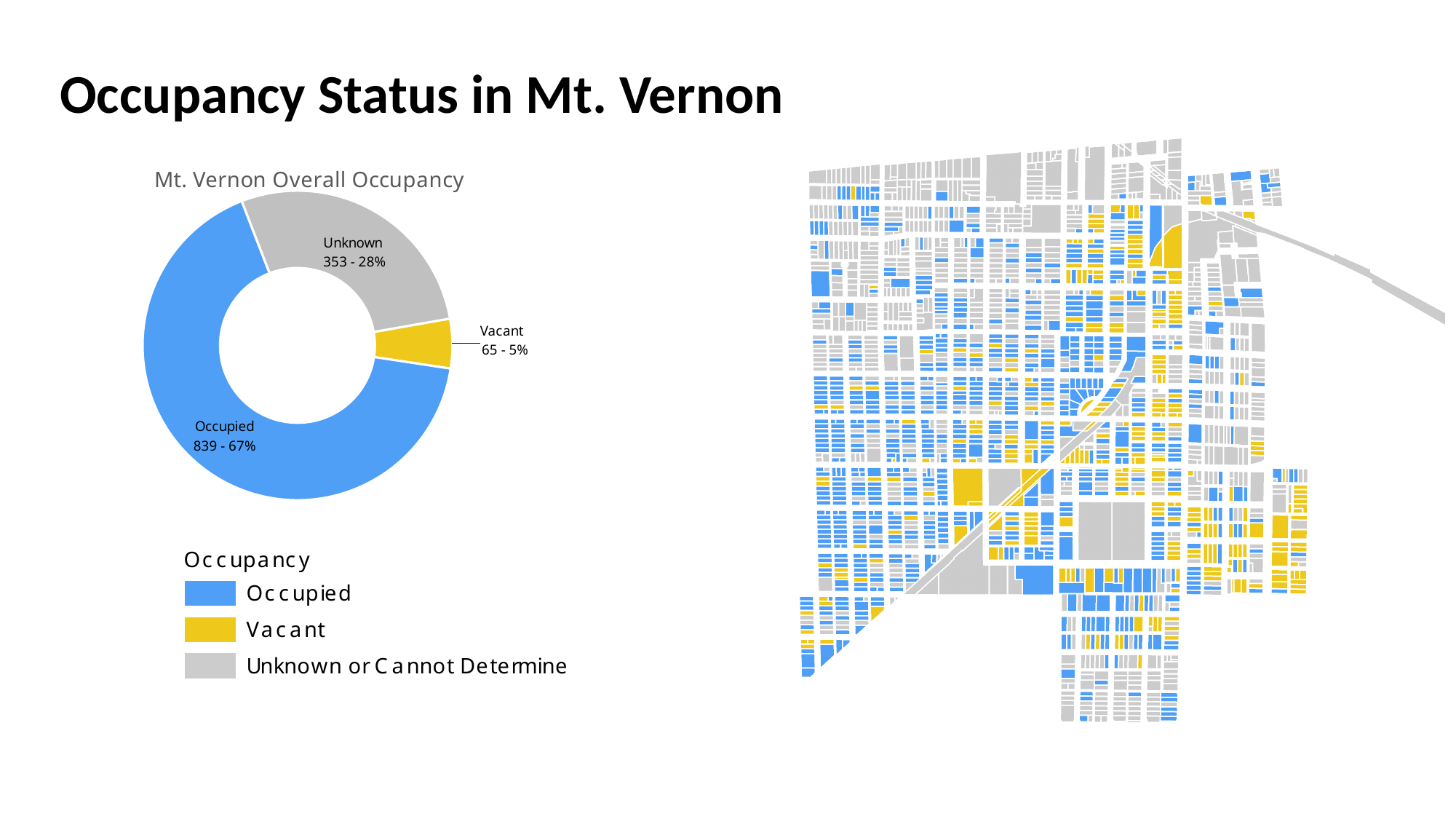
What type of chart is the Mt. Vernon Overall Occupancy chart? Donut (pie) chart In the Mt. Vernon Overall Occupancy chart, how many properties have Unknown occupancy? 353 In the Mt. Vernon Overall Occupancy chart, which is larger: the Unknown count or the Vacant count? Unknown How many categories are shown in the Mt. Vernon Overall Occupancy chart? 3 In the Mt. Vernon Overall Occupancy chart, what percentage of properties are Unknown? 28% What colour represents Vacant properties in the Occupancy legend? Yellow Which category has the smallest share in the Mt. Vernon Overall Occupancy chart? Vacant In the Mt. Vernon Overall Occupancy chart, what percentage of properties are Vacant? 5% Which category has the largest share in the Mt. Vernon Overall Occupancy chart? Occupied In the Mt. Vernon Overall Occupancy chart, how many more properties are Occupied than Unknown? 486 In the Mt. Vernon Overall Occupancy chart, how many properties are Occupied? 839 What is the total number of properties across all three categories in the Mt. Vernon Overall Occupancy chart? 1257